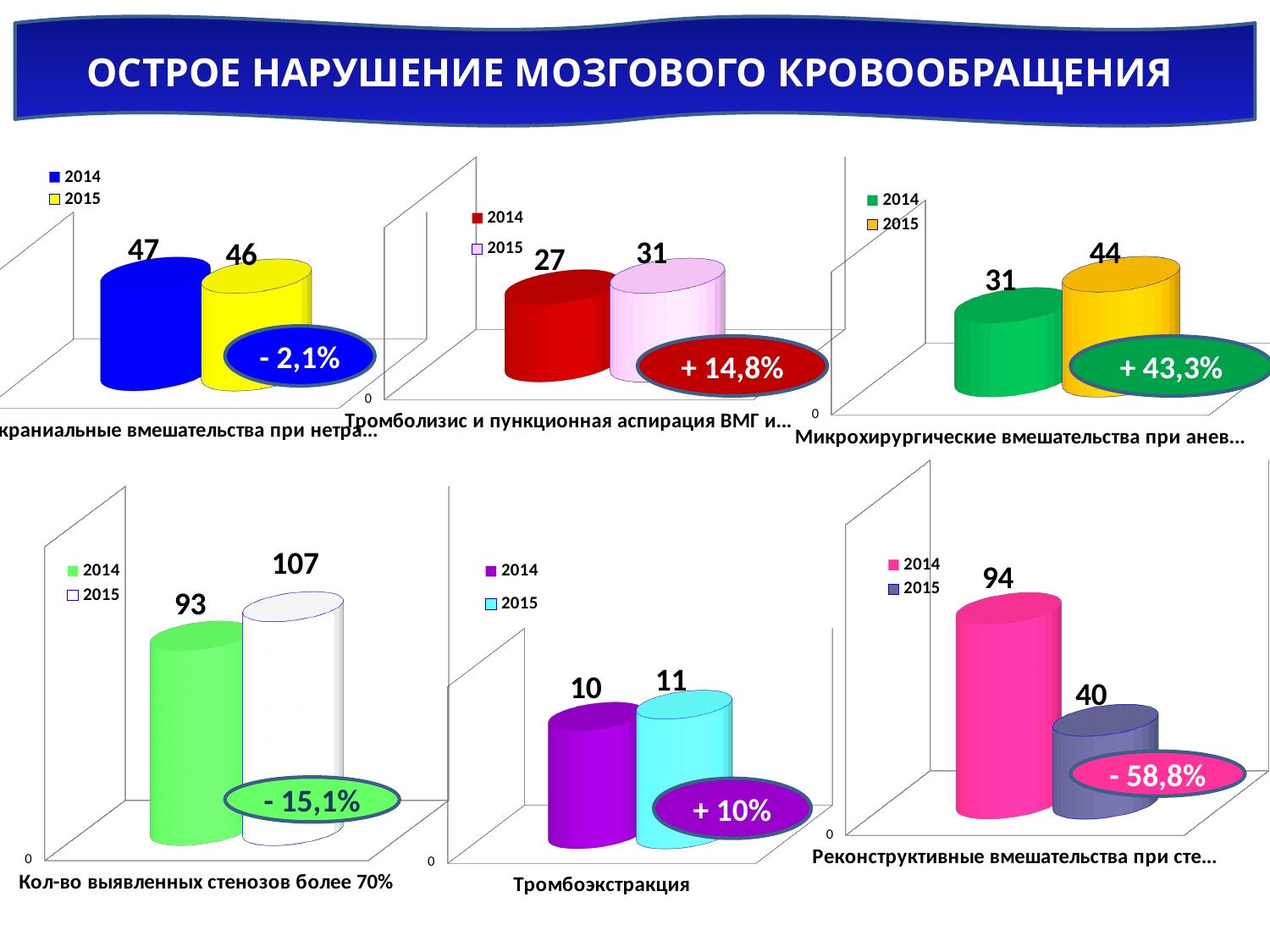
In the bottom-right chart (Реконструктивные вмешательства при сте...), what is the value for 2015? 40 In the chart titled "Кол-во выявленных стенозов более 70%", what is the difference between the 2015 and 2014 values? 14 In the top-middle chart (Тромболизис и пункционная аспирация ВМГ и...), what is the value for 2015? 31 In the top-right chart (Микрохирургические вмешательства при анев...), what is the difference between the 2015 and 2014 values? 13 What kind of chart is the chart titled "Кол-во выявленных стенозов более 70%"? bar chart In the bottom-right chart (Реконструктивные вмешательства при сте...), which year has the higher value, 2014 or 2015? 2014 In the chart titled "Тромбоэкстракция", what is the value for 2015? 11 In the chart titled "Кол-во выявленных стенозов более 70%", what is the value for 2015? 107 In the top-right chart (Микрохирургические вмешательства при анев...), what is the value for 2014? 31 How many series does the legend list in the chart titled "Тромбоэкстракция"? 2 In the top-left chart, what is the value for 2014? 47 In the chart titled "Тромбоэкстракция", what is the value for 2014? 10